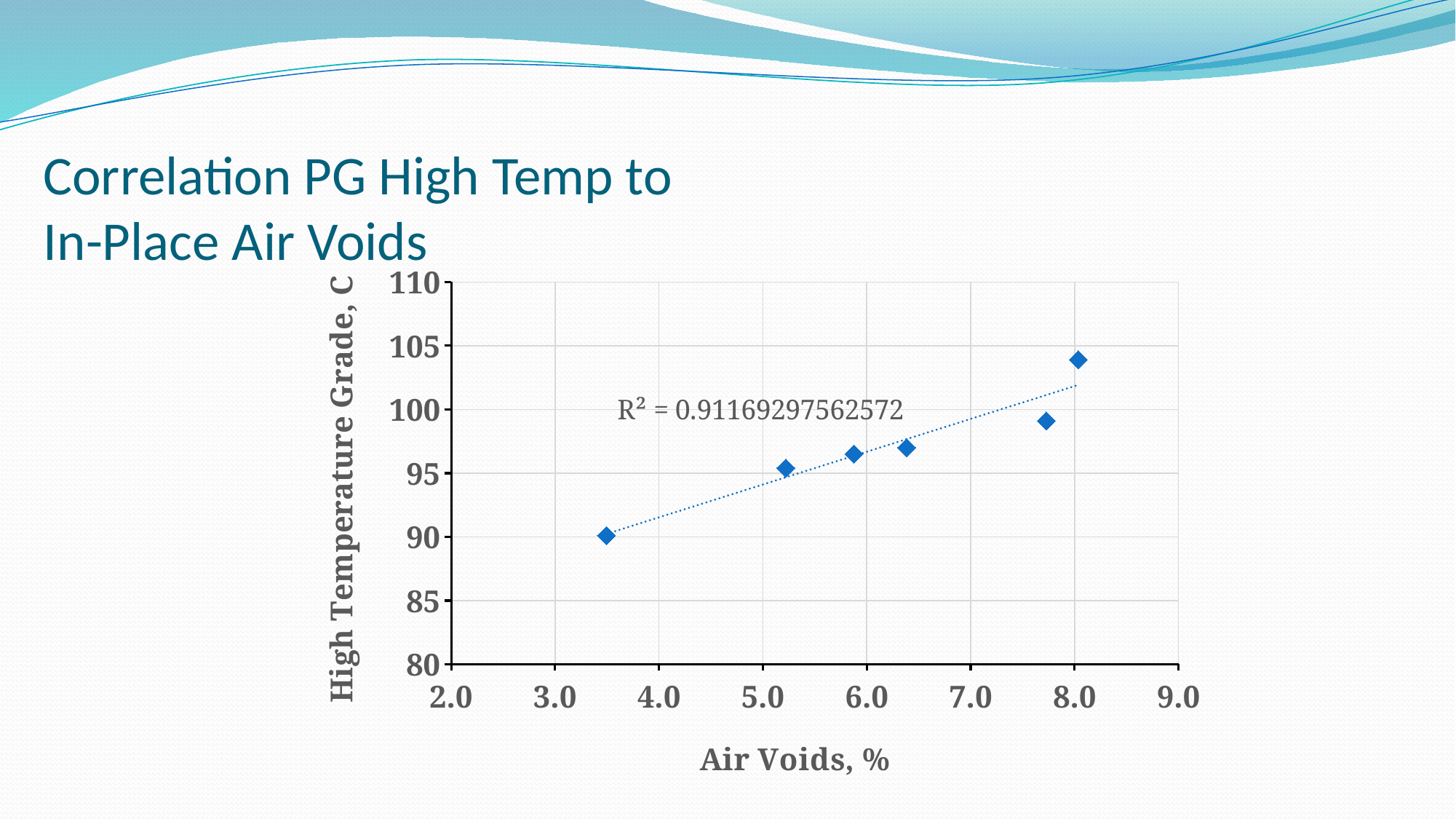
Is the high temperature grade of the rightmost data point greater or less than 100? greater Is the air voids value of the rightmost data point greater or less than 7.0? greater What R² value is printed on the chart? 0.91169297562572 Is the air voids value of the leftmost data point greater or less than 4.0? less Which data point has the lowest high temperature grade: the leftmost or the rightmost? leftmost How many data points are plotted on the chart? 6 What is the title of the x axis? Air Voids, % What kind of chart is shown on the slide? scatter chart Do the high temperature grade values rise or fall as air voids increase along the x axis? rise Which data point has the highest high temperature grade: the leftmost or the rightmost? rightmost